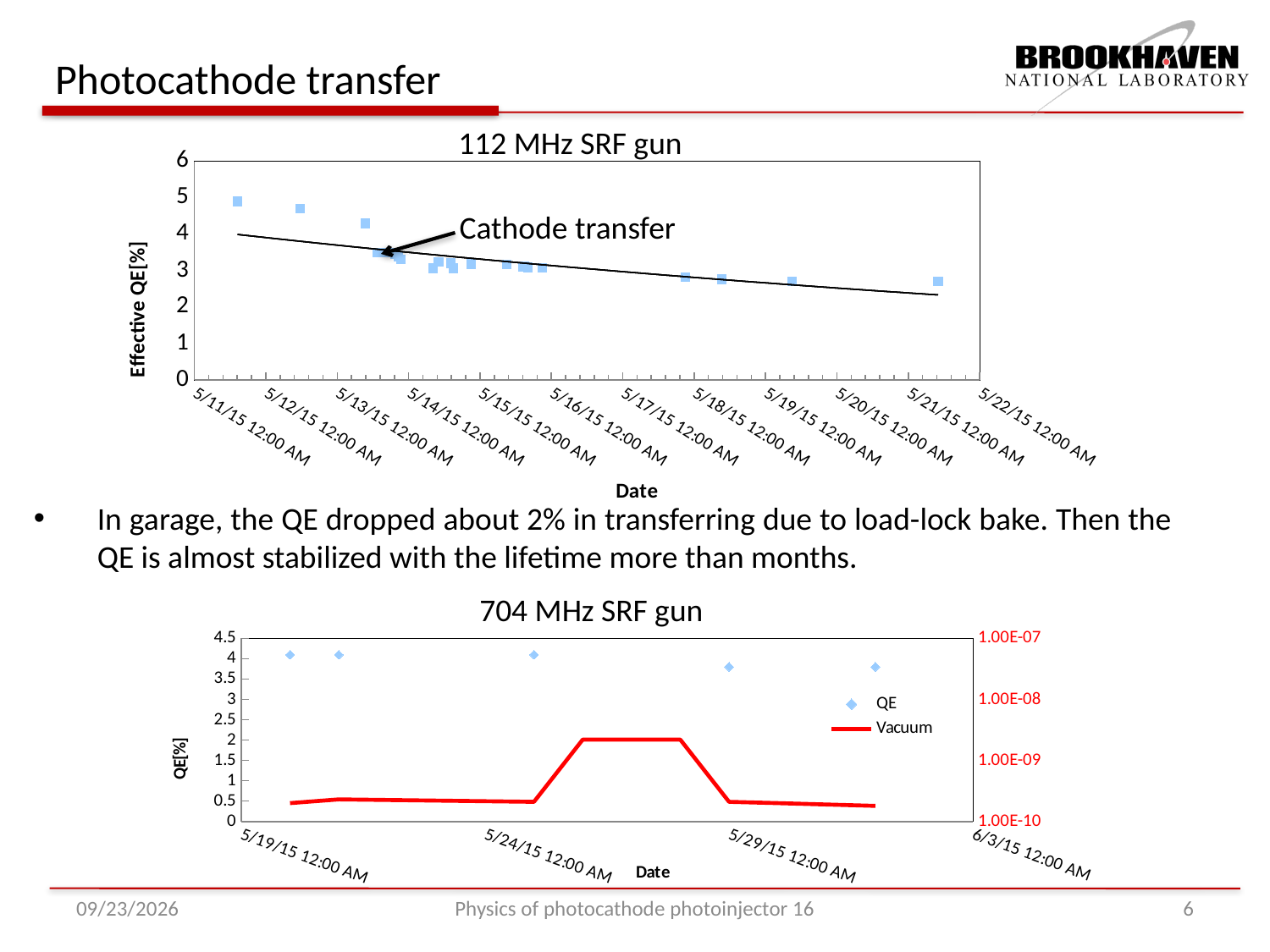
What type of chart is the '112 MHz SRF gun' chart? scatter chart In the '112 MHz SRF gun' chart, is the first data point (near 5/11/15) greater or less than 4? greater How many QE data points are plotted in the '704 MHz SRF gun' chart? 5 In the '704 MHz SRF gun' chart, what is the maximum value shown on the left y-axis? 4.5 In the '112 MHz SRF gun' chart, do the Effective QE values rise or fall over the dates shown? fall What is the y-axis label of the '112 MHz SRF gun' chart? Effective QE[%] How many series does the legend of the '704 MHz SRF gun' chart list? 2 What event is annotated with an arrow in the '112 MHz SRF gun' chart? Cathode transfer In the '112 MHz SRF gun' chart, is the last data point (near 5/21/15) greater or less than 3? less